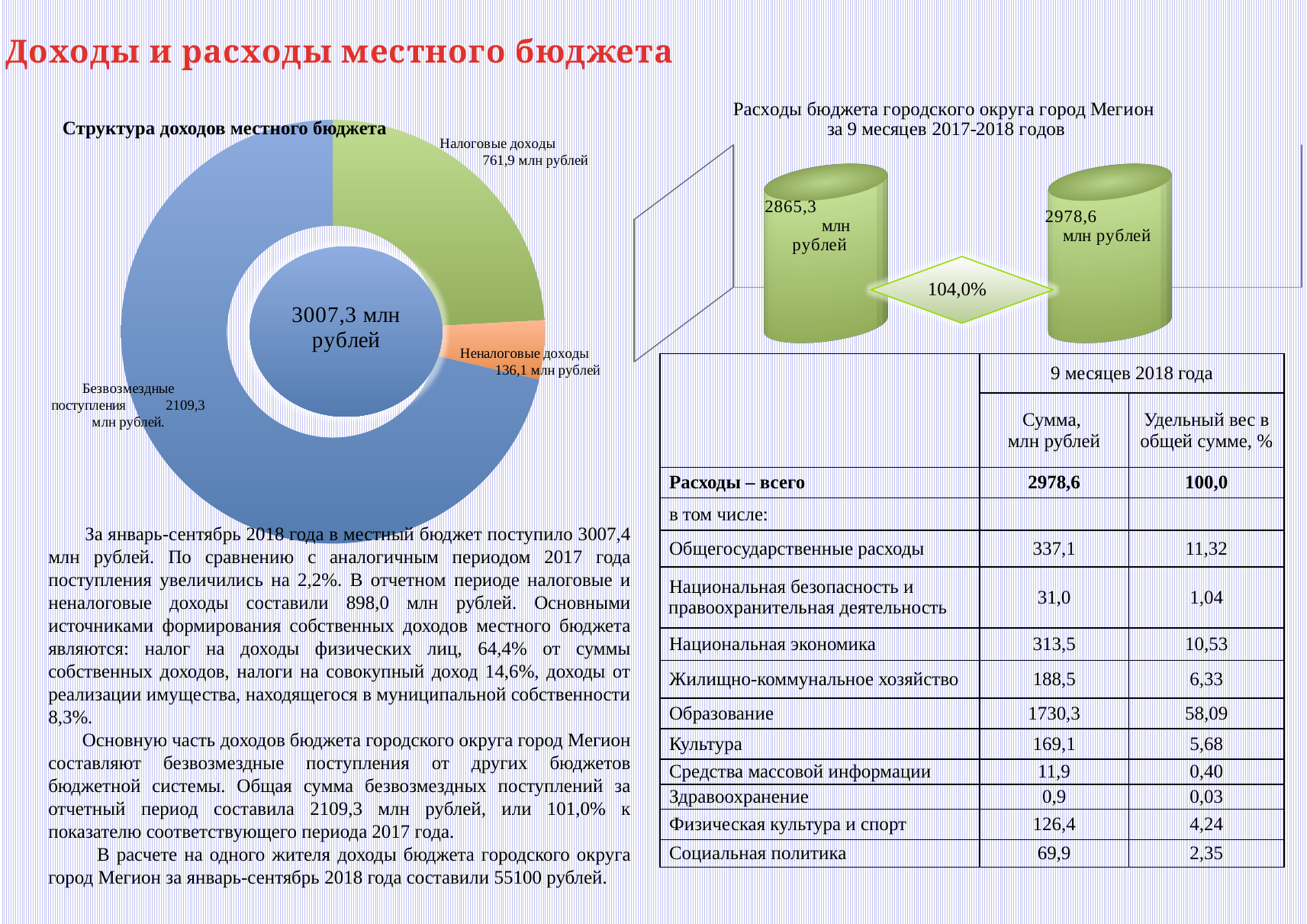
On the chart 'Расходы бюджета городского округа город Мегион за 9 месяцев 2017-2018 годов', what is the difference between the two values? 113,3 млн рублей On the chart 'Структура доходов местного бюджета', what is the value for Налоговые доходы? 761,9 млн рублей On the chart 'Структура доходов местного бюджета', how many categories are shown? 3 On the chart 'Структура доходов местного бюджета', which category has the largest value? Безвозмездные поступления On the chart 'Структура доходов местного бюджета', what total is shown in the centre of the doughnut? 3007,3 млн рублей On the chart 'Структура доходов местного бюджета', which category has the smallest value? Неналоговые доходы On the chart 'Структура доходов местного бюджета', what is the value for Безвозмездные поступления? 2109,3 млн рублей On the chart 'Расходы бюджета городского округа город Мегион за 9 месяцев 2017-2018 годов', what are the two values shown on the cylinders? 2865,3 млн рублей and 2978,6 млн рублей On the chart 'Структура доходов местного бюджета', what is the difference between Безвозмездные поступления and Налоговые доходы? 1347,4 млн рублей On the chart 'Структура доходов местного бюджета', which is larger: Налоговые доходы or Неналоговые доходы? Налоговые доходы What kind of chart is 'Структура доходов местного бюджета'? Doughnut (pie) chart On the chart 'Структура доходов местного бюджета', what is the value for Неналоговые доходы? 136,1 млн рублей